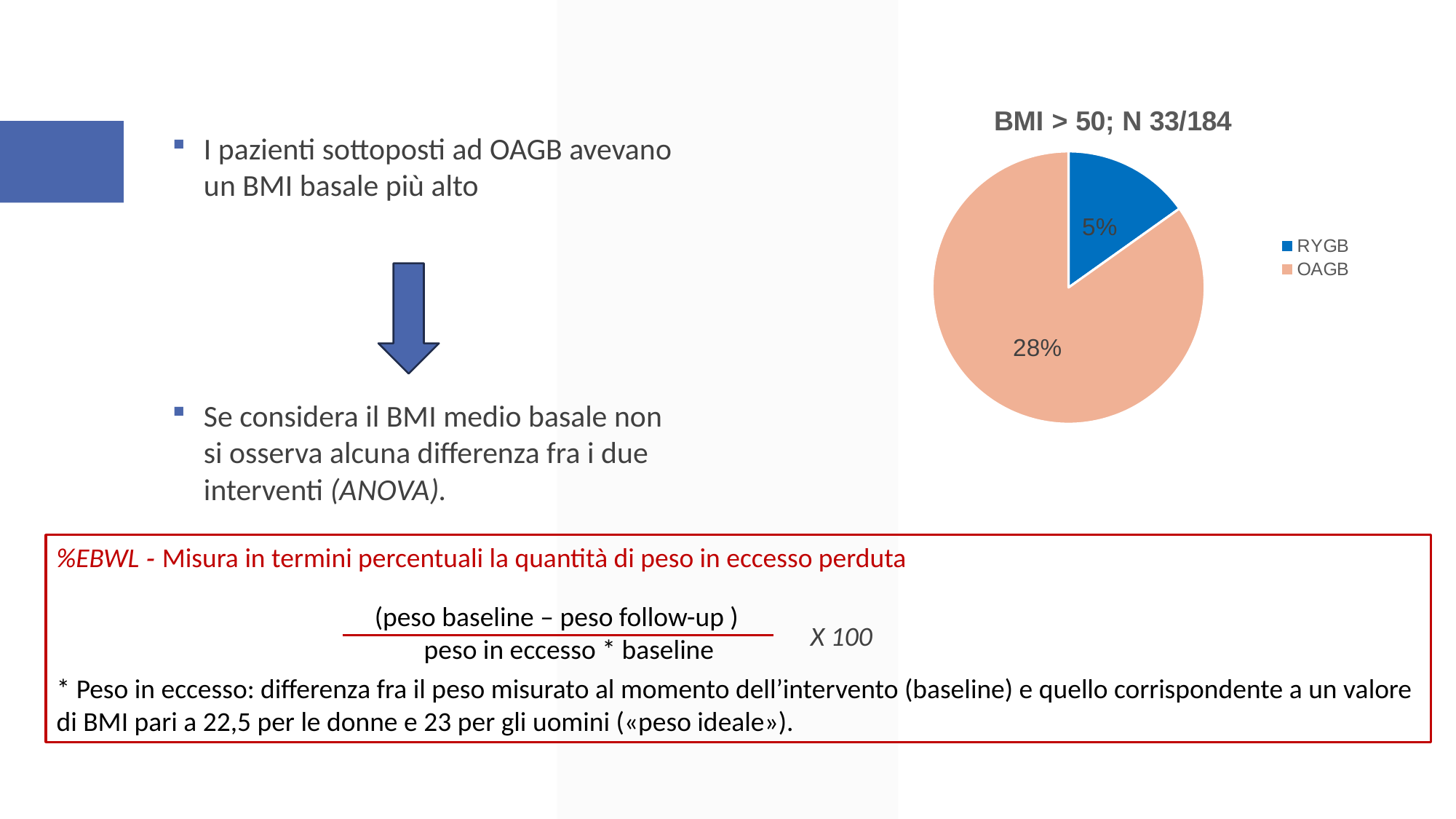
What is the difference between the OAGB and RYGB values labelled on the pie chart? 23% What value is labelled on the OAGB slice of the pie chart? 28% How many entries does the legend of the pie chart list? 2 What value is labelled on the RYGB slice of the pie chart? 5% How many slices does the pie chart have? 2 Which slice of the pie chart is the largest? OAGB What kind of chart is shown on the slide? pie chart Which slice of the pie chart is the smallest? RYGB What is the title of the pie chart? BMI > 50; N 33/184 Which is larger in the pie chart, RYGB or OAGB? OAGB Which colour represents OAGB in the pie chart? orange